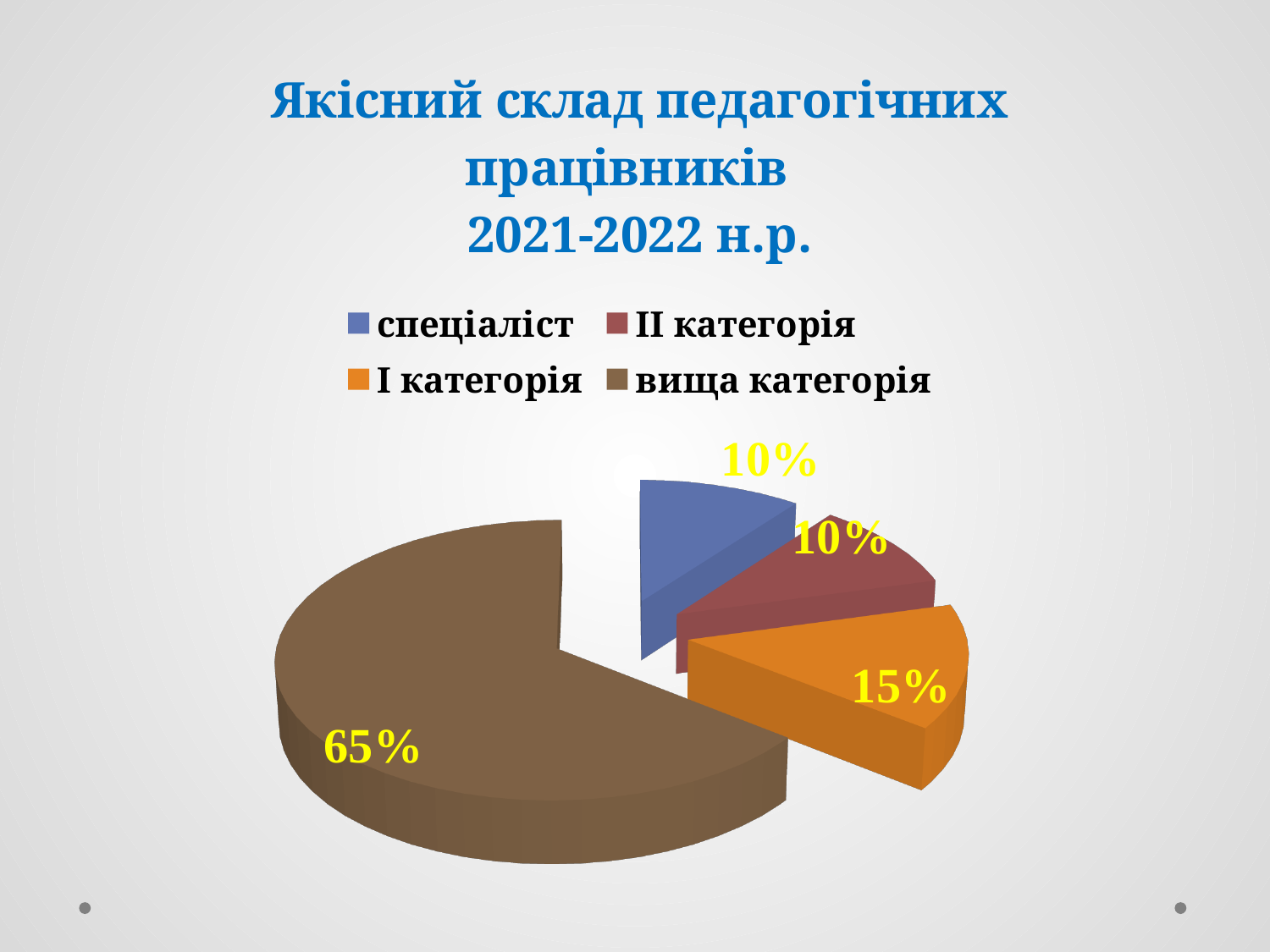
What percentage of the pie is labelled for вища категорія? 65% What kind of chart is shown on the slide? pie chart Which is larger, the share for І категорія or the share for спеціаліст? І категорія What percentage is shown for І категорія? 15% What is the difference between the share for вища категорія and the share for І категорія? 50% What is the difference between the share for І категорія and the share for ІІ категорія? 5% Which category has the largest share of the pie? вища категорія What percentage is shown for ІІ категорія? 10% How many slices does the pie chart have? 4 What percentage is shown for спеціаліст? 10% Which colour represents вища категорія in the legend? brown What is the title of the chart? Якісний склад педагогічних працівників 2021-2022 н.р.